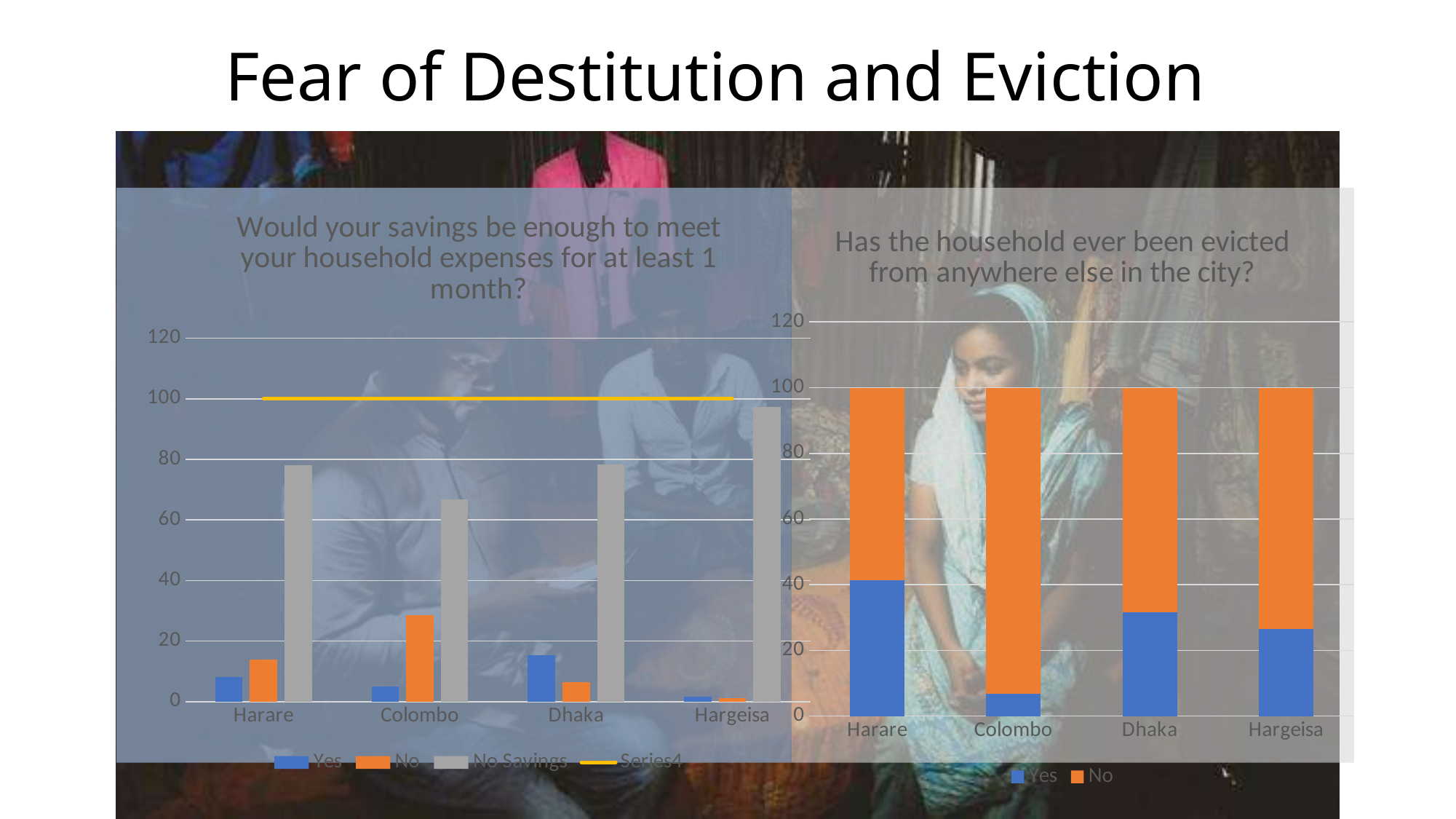
In the chart titled "Would your savings be enough to meet your household expenses for at least 1 month?", what colour are the No Savings bars? Grey How many series does the legend list for the chart titled "Has the household ever been evicted from anywhere else in the city?"? 2 In the chart titled "Would your savings be enough to meet your household expenses for at least 1 month?", which city has the lowest No Savings value? Colombo In the chart titled "Has the household ever been evicted from anywhere else in the city?", which city has the highest Yes value? Harare In the chart titled "Would your savings be enough to meet your household expenses for at least 1 month?", is the No Savings value for Harare greater or less than 60? greater In the chart titled "Would your savings be enough to meet your household expenses for at least 1 month?", which city has the highest No Savings value? Hargeisa In the chart titled "Has the household ever been evicted from anywhere else in the city?", which city has the lowest Yes value? Colombo What kind of chart is the chart titled "Has the household ever been evicted from anywhere else in the city?"? Stacked bar chart How many series does the legend list for the chart titled "Would your savings be enough to meet your household expenses for at least 1 month?"? 4 How many cities are shown on the x axis of the chart titled "Would your savings be enough to meet your household expenses for at least 1 month?"? 4 In the chart titled "Has the household ever been evicted from anywhere else in the city?", is the Yes value for Dhaka greater or less than 20? greater In the chart titled "Would your savings be enough to meet your household expenses for at least 1 month?", which is larger for Harare, the Yes value or the No value? No